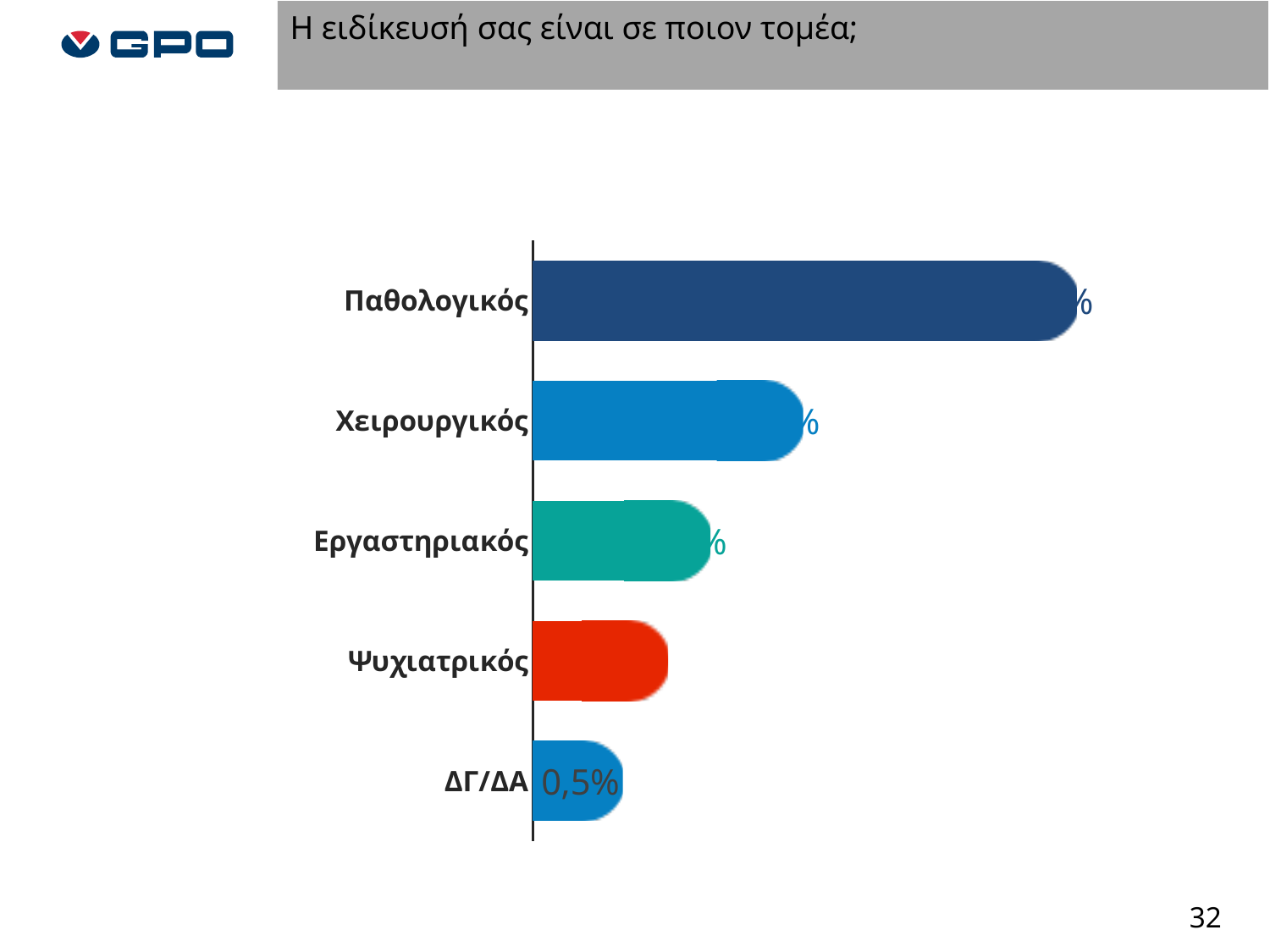
How many categories are shown in the chart? 5 Which category has the lowest value? ΔΓ/ΔΑ What colour is the bar for Ψυχιατρικός? Red Which is larger, the value for Ψυχιατρικός or the value for Παθολογικός? Παθολογικός Which is larger, the value for Εργαστηριακός or the value for Ψυχιατρικός? Εργαστηριακός Which is larger, the value for Χειρουργικός or the value for Εργαστηριακός? Χειρουργικός Which category has the highest value? Παθολογικός What kind of chart is shown on the slide? Bar chart What is the value for ΔΓ/ΔΑ? 0,5% Do the bar values increase or decrease going from the top category to the bottom category? Decrease What is the title of the slide? Η ειδίκευσή σας είναι σε ποιον τομέα;